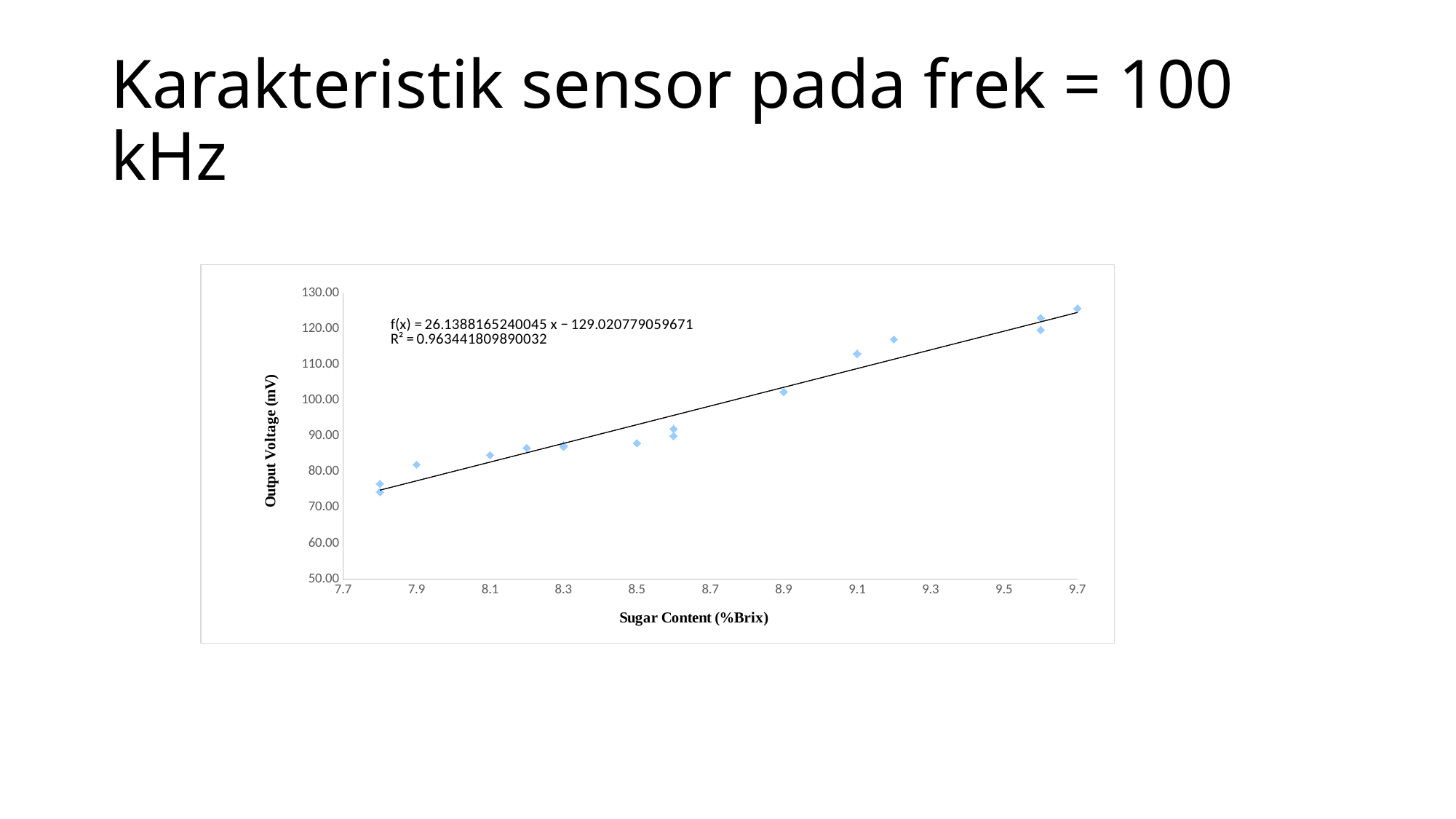
Which sugar content value has the lowest output voltage? 7.8 Is the output voltage at a sugar content of 7.9 %Brix greater or less than 90 mV? less Does the output voltage rise or fall as sugar content increases along the x axis? Rise Which has a larger output voltage: the point at 9.2 %Brix or the point at 8.3 %Brix? 9.2 %Brix What kind of chart is shown on the slide? Scatter chart Which sugar content value has the highest output voltage? 9.7 What is the R² value shown for the trendline? 0.963441809890032 Is the output voltage at a sugar content of 8.9 %Brix greater or less than 90 mV? greater Is the output voltage at a sugar content of 9.7 %Brix greater or less than 120 mV? greater What is the title of the y axis? Output Voltage (mV)